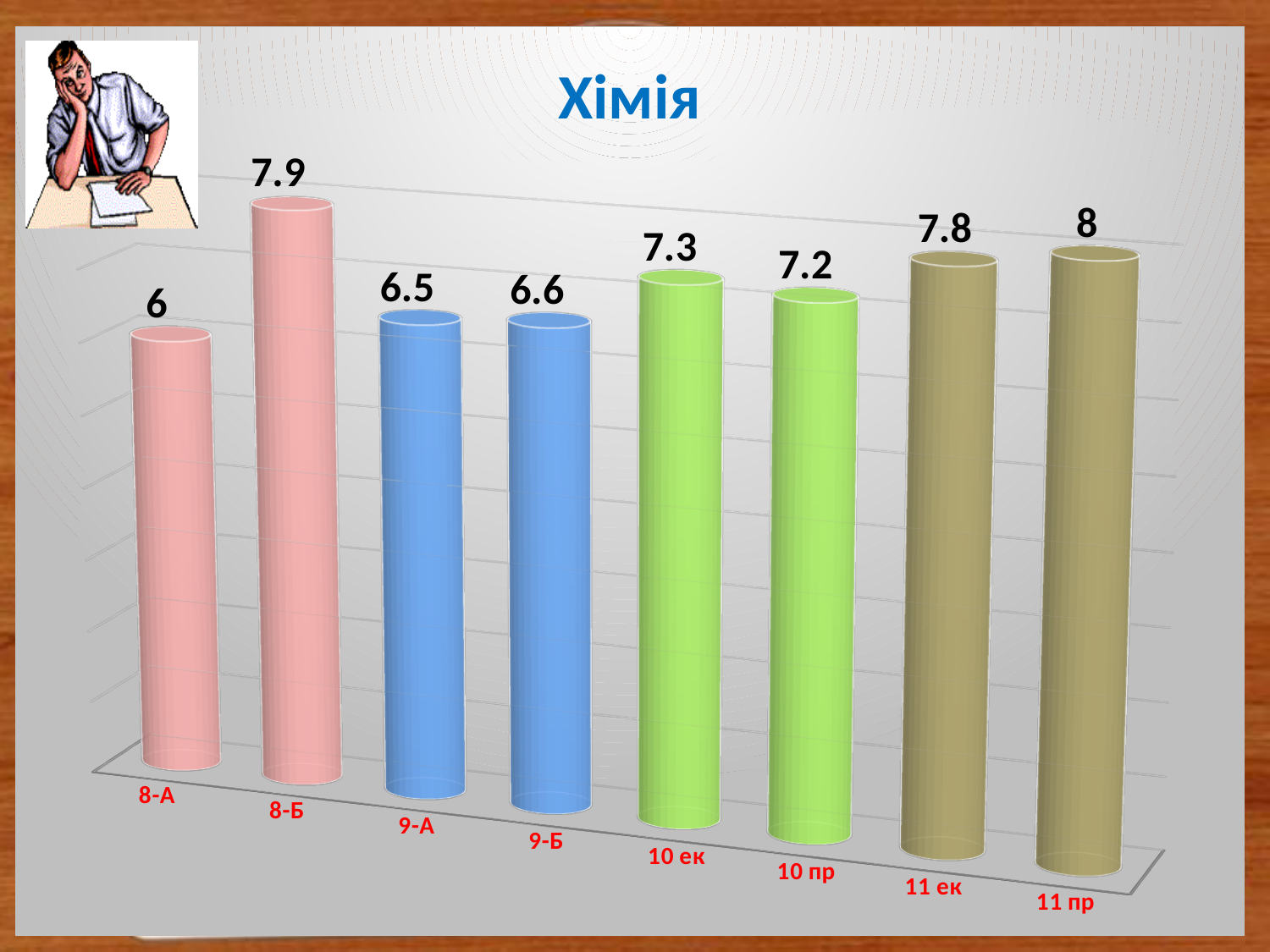
What is the title of the chart? Хімія Which is larger, the value for 10 ек or the value for 11 ек? 11 ек Which category has the highest value? 11 пр What kind of chart is shown on the slide? bar chart What is the value for 10 пр? 7.2 What is the value for 8-Б? 7.9 Which category has the lowest value? 8-А Which is larger, the value for 9-Б or the value for 8-Б? 8-Б How many categories are shown in the chart? 8 What is the difference between the values for 11 пр and 9-А? 1.5 What is the difference between the values for 8-Б and 8-А? 1.9 What is the value for 11 пр? 8